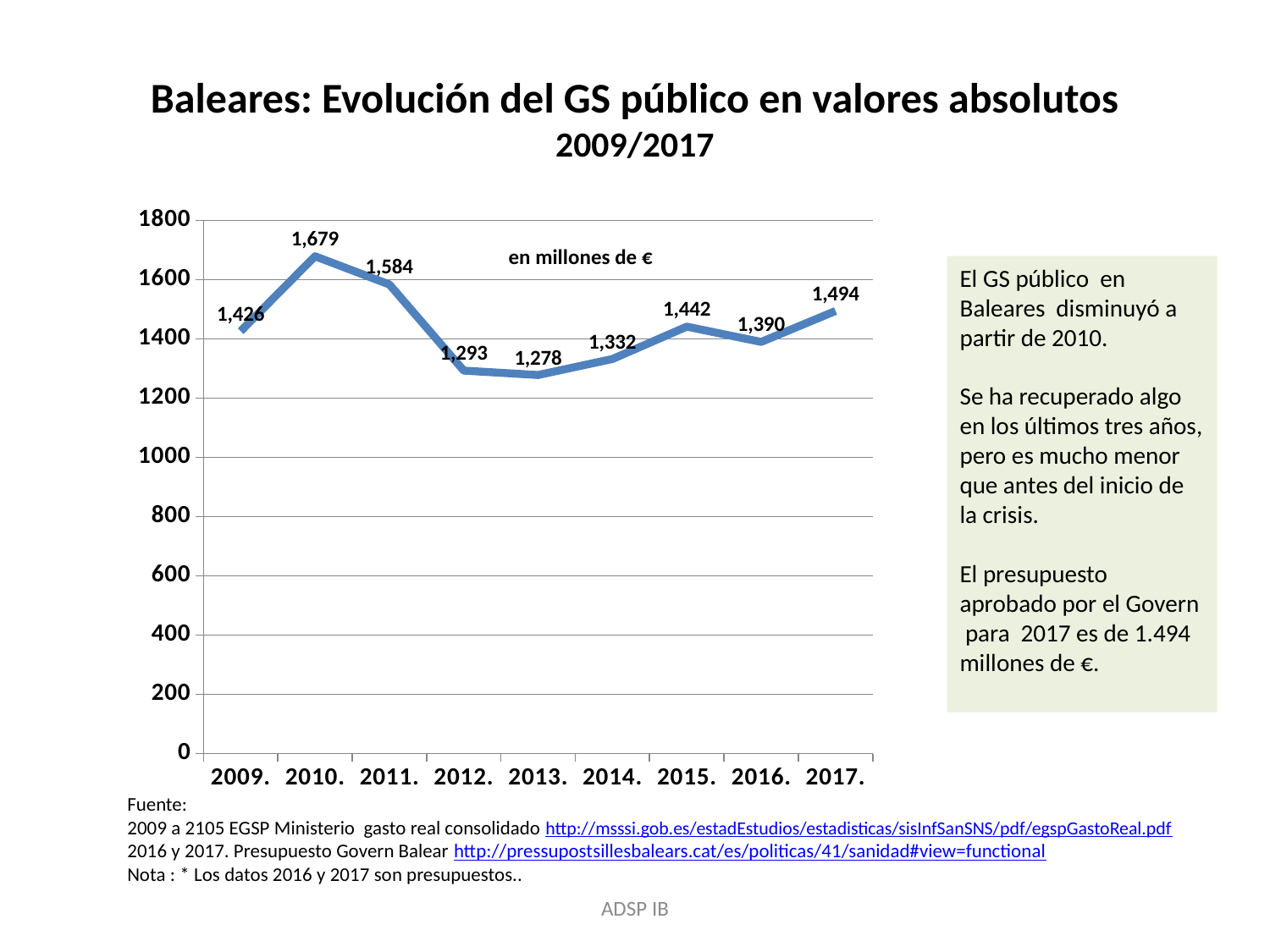
Which is larger, the value for 2009 or the value for 2017? 2017 What is the value for 2010? 1,679 Is the value for 2012 greater or less than 1400? less How many years are plotted on the chart? 9 What unit is stated on the chart for the values? en millones de € What kind of chart is shown? line chart What is the value for 2013? 1,278 Do the values rise or fall from 2010 to 2013? fall Which year has the highest value? 2010 Which year has the lowest value? 2013 What is the value for 2017? 1,494 What is the difference between the values for 2010 and 2013? 401